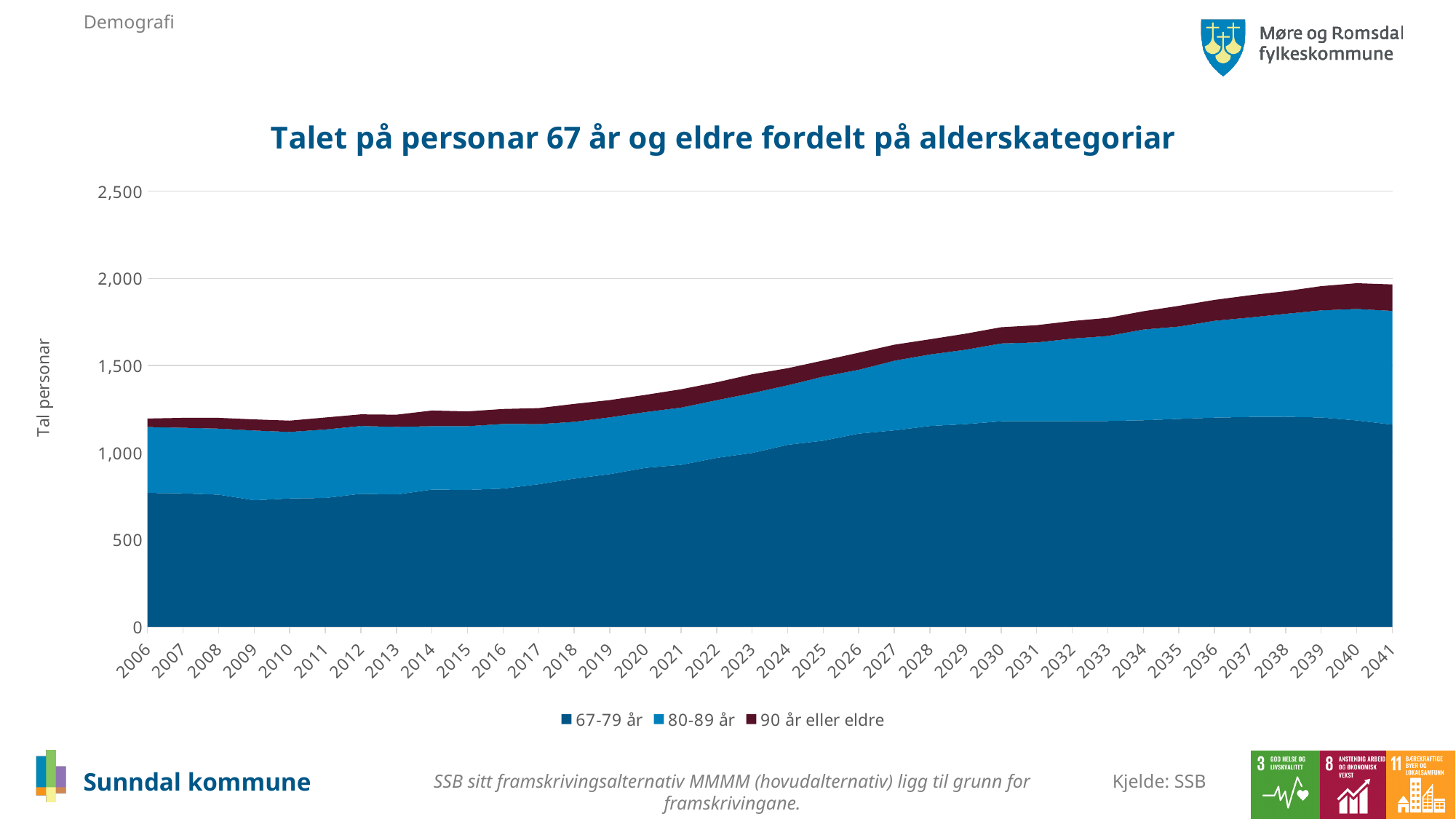
How many years are shown along the x axis? 36 What is the label on the y axis? Tal personar Does the total number of persons 67 years and older rise or fall from 2006 to 2041? Rise How many series does the legend list? 3 Which age category has the largest number of persons throughout the period? 67-79 år What kind of chart is shown on the slide? Stacked area chart What is the title of the chart? Talet på personar 67 år og eldre fordelt på alderskategoriar Is the total for all age categories in 2041 greater or less than 1,500? greater Which age category has the smallest number of persons throughout the period? 90 år eller eldre Is the value for 67-79 år in 2006 greater or less than 500? greater Is the value for 67-79 år in 2041 greater or less than 1,000? greater